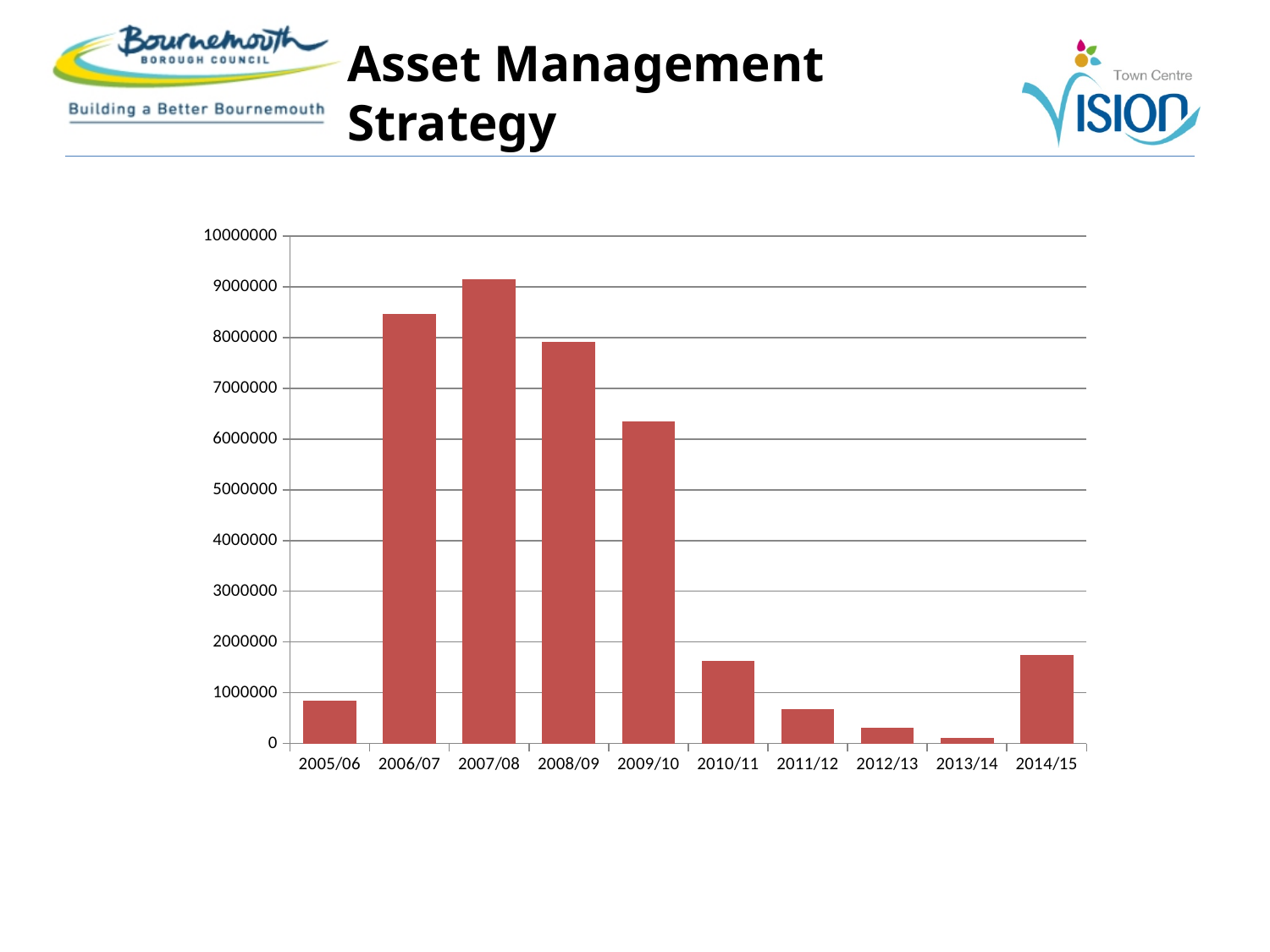
Is the value for 2009/10 greater or less than 7000000? less How many years are shown on the x axis of the chart? 10 Do the values rise or fall from 2007/08 to 2013/14? Fall Which year has the larger value, 2006/07 or 2008/09? 2006/07 Which year has the larger value, 2005/06 or 2011/12? 2005/06 Which year has the lowest bar in the chart? 2013/14 Is the value for 2005/06 greater or less than 1000000? less Which year has the highest bar in the chart? 2007/08 What kind of chart is shown on the slide? Bar chart Which year has the larger value, 2010/11 or 2014/15? 2014/15 Is the value for 2007/08 greater or less than 9000000? greater What is the highest value shown on the y axis of the chart? 10000000